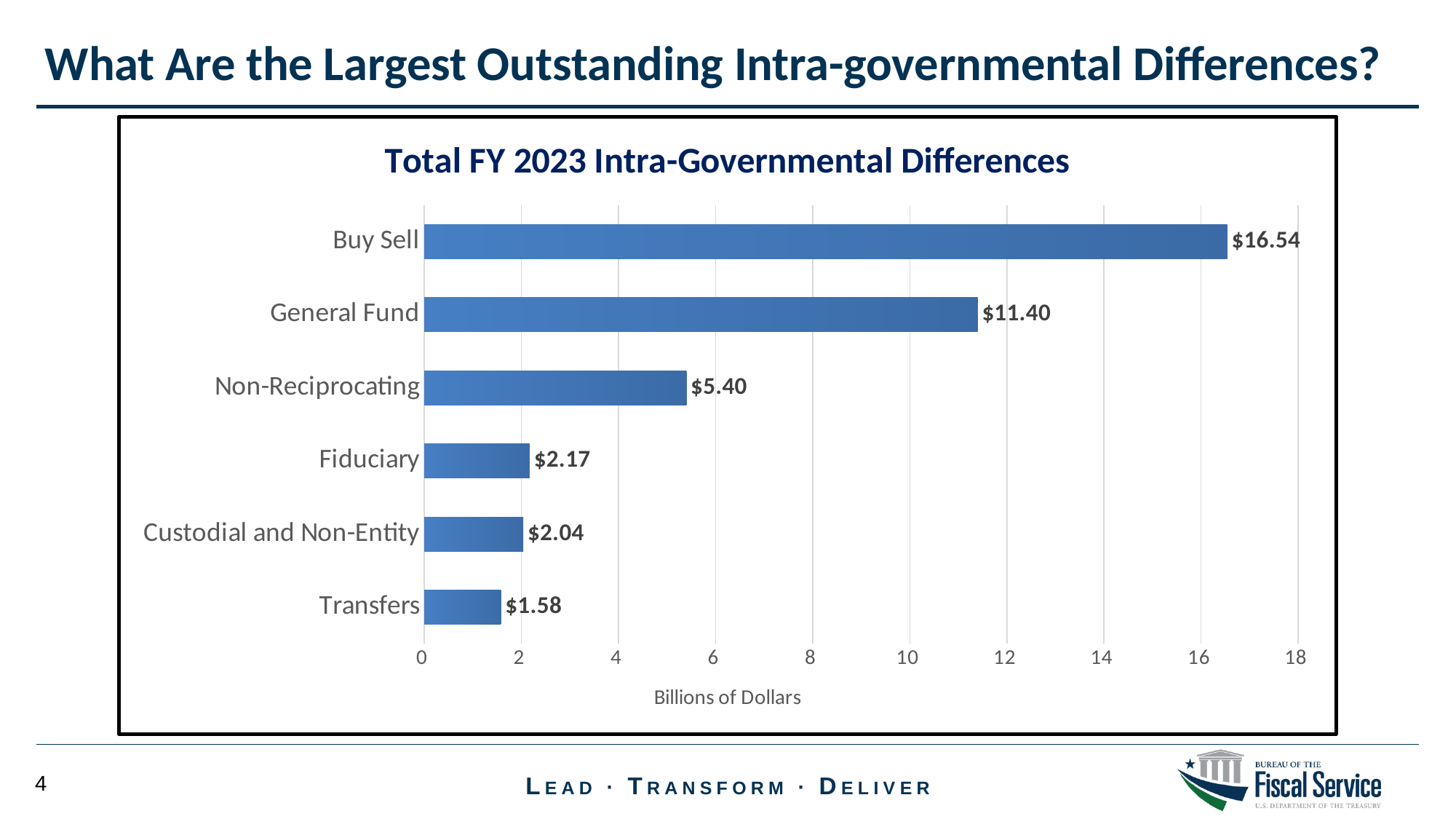
What is the difference between the values for Fiduciary and Transfers? $0.59 What is the difference between the values for Buy Sell and General Fund? $5.14 What kind of chart is shown on the slide? Bar chart How many categories are shown in the chart? 6 Which is larger, the value for General Fund or the value for Non-Reciprocating? General Fund Which category has the highest value? Buy Sell Is the value for General Fund greater or less than 10? greater What is the value for Buy Sell? $16.54 What is the value for Non-Reciprocating? $5.40 What is the value for Custodial and Non-Entity? $2.04 Which category has the lowest value? Transfers What is the title of the chart? Total FY 2023 Intra-Governmental Differences